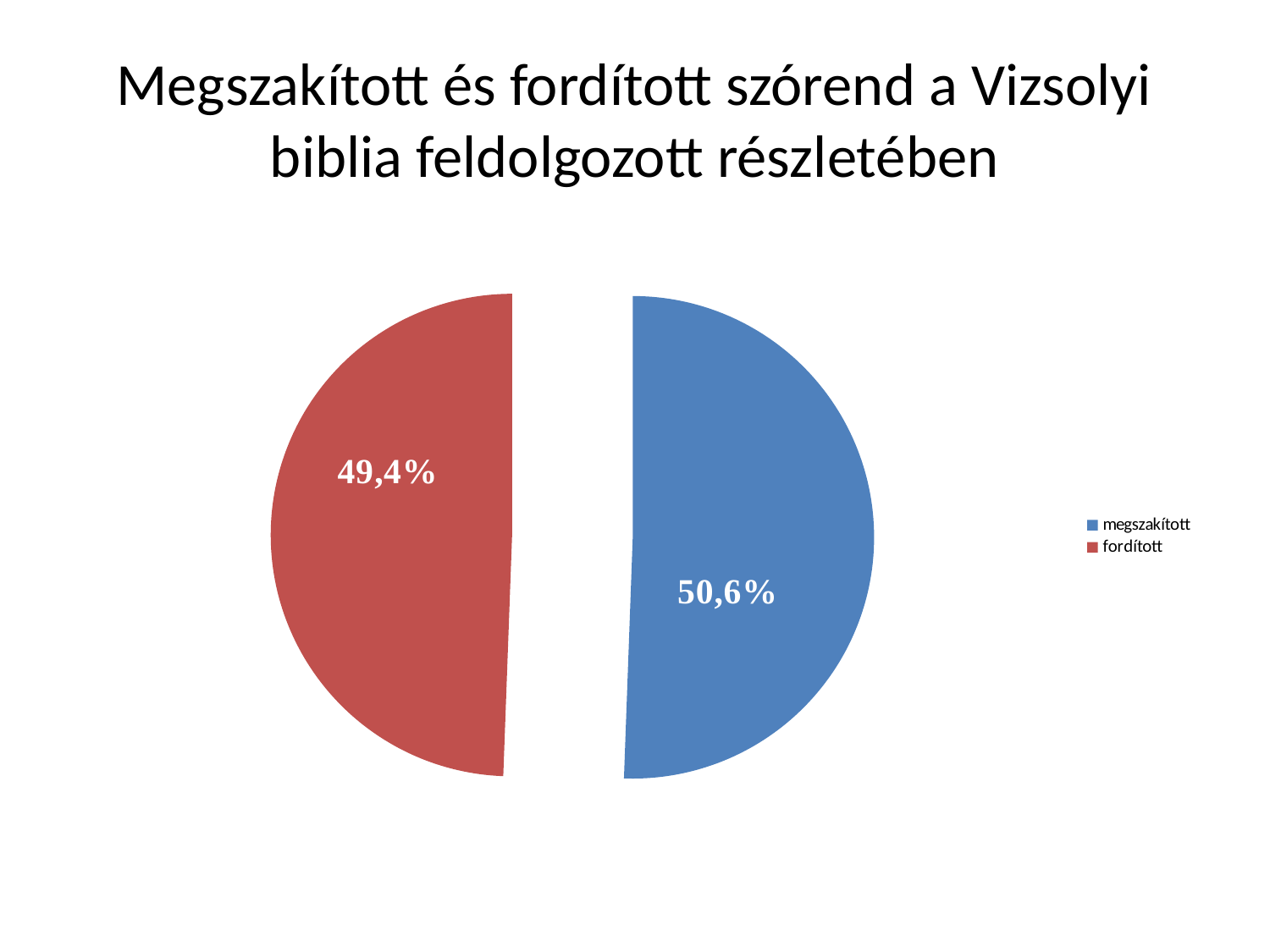
Which category has the smallest share of the pie? fordított What share of the pie does the 'fordított' slice represent? 49,4% What share of the pie does the 'megszakított' slice represent? 50,6% How many slices does the pie chart have? 2 What is the difference in percentage points between the 'megszakított' and 'fordított' shares? 1,2 What is the value labelled on the red slice? 49,4% Which category has the largest share of the pie? megszakított Which colour represents 'fordított' in the chart? red How many entries does the legend list? 2 What is the value labelled on the blue slice? 50,6% Which category has the larger share, 'megszakított' or 'fordított'? megszakított What kind of chart is shown on the slide? pie chart